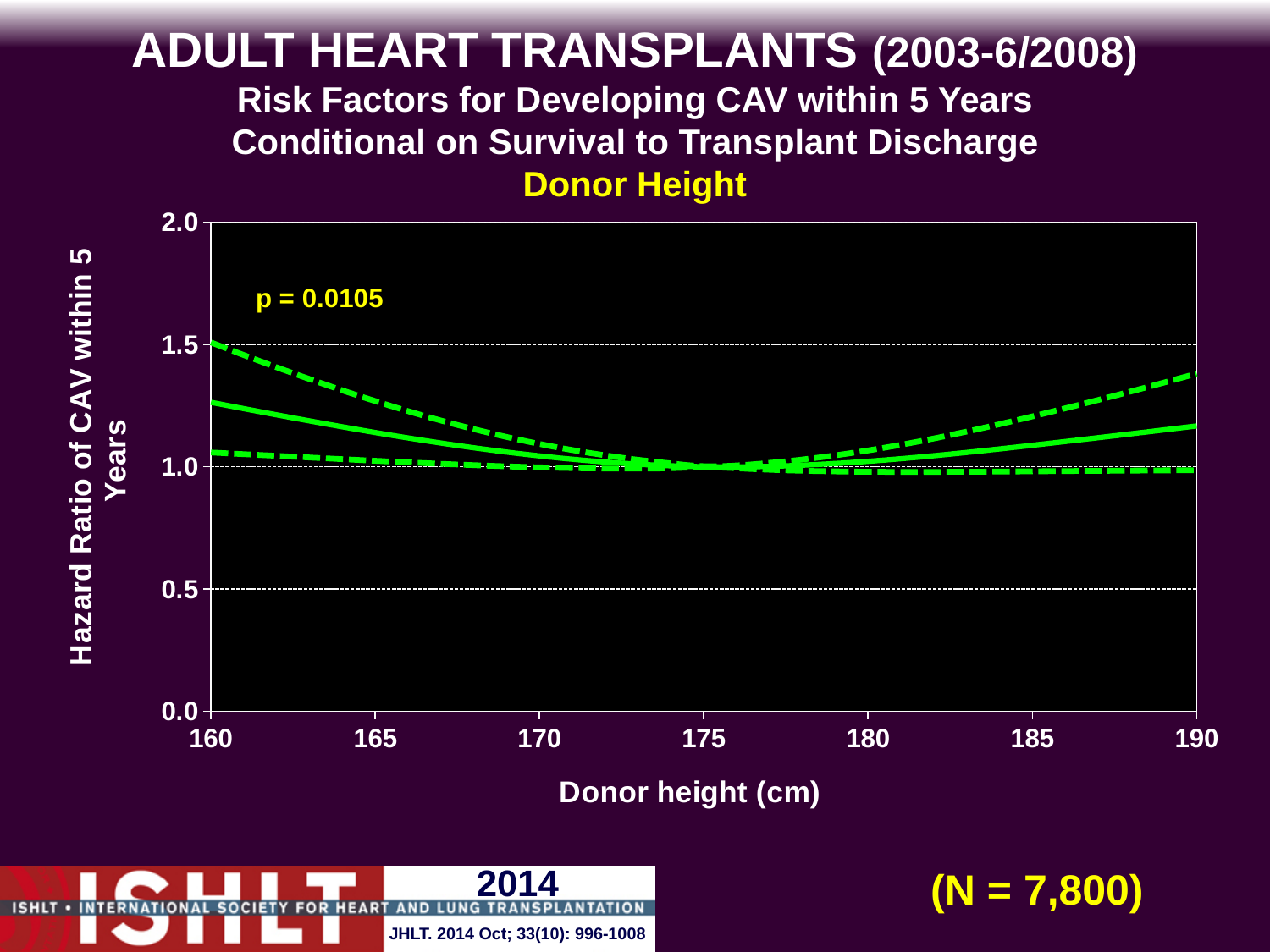
Is the upper dashed line at a donor height of 190 cm greater or less than 1.5? less Is the hazard ratio on the solid line at a donor height of 160 cm greater or less than 1.5? less Is the solid line's hazard ratio higher at a donor height of 160 cm or at 175 cm? 160 cm What sample size (N) is shown on the slide? N = 7,800 Is the hazard ratio on the solid line at a donor height of 160 cm greater or less than 1.0? greater Does the solid line rise or fall as donor height increases from 160 cm to 175 cm? fall Does the solid line rise or fall as donor height increases from 180 cm to 190 cm? rise What kind of chart is shown on the slide? line chart What p-value is printed on the chart? p = 0.0105 How many lines are plotted on the chart? 3